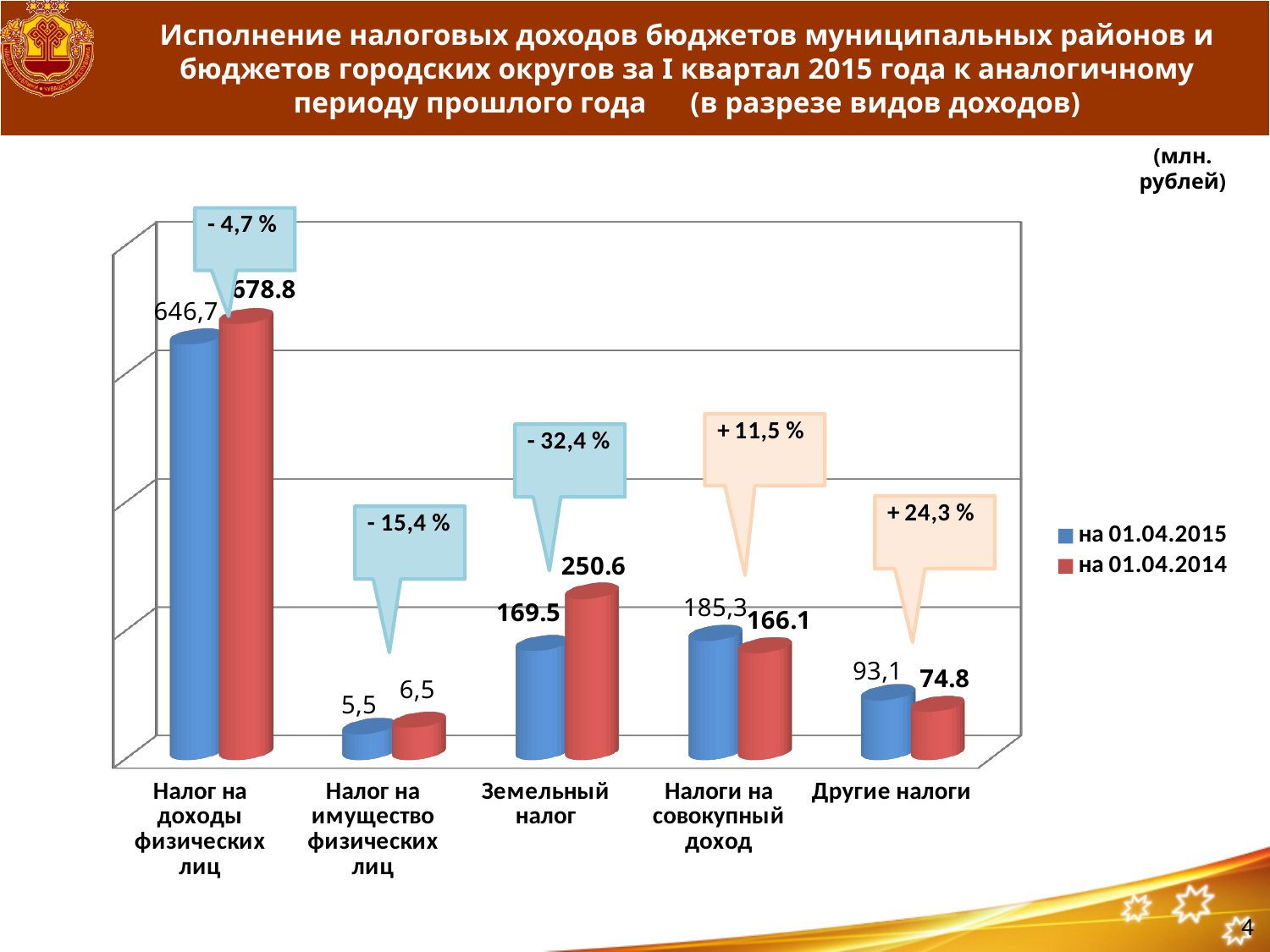
Which category has the highest value for the series на 01.04.2015? Налог на доходы физических лиц What is the value for Налоги на совокупный доход for the series на 01.04.2015? 185,3 What is the value for Земельный налог for the series на 01.04.2015? 169.5 What is the value for Налог на имущество физических лиц for the series на 01.04.2015? 5,5 How many series does the legend list? 2 What is the value for Земельный налог for the series на 01.04.2014? 250.6 For Другие налоги, which series has the larger value, на 01.04.2015 or на 01.04.2014? на 01.04.2015 For Земельный налог, what is the difference between the на 01.04.2014 value and the на 01.04.2015 value? 81.1 What is the value for Другие налоги for the series на 01.04.2014? 74.8 Which category has the lowest value for the series на 01.04.2014? Налог на имущество физических лиц What kind of chart is shown on the slide? bar chart How many tax categories are shown on the x axis? 5